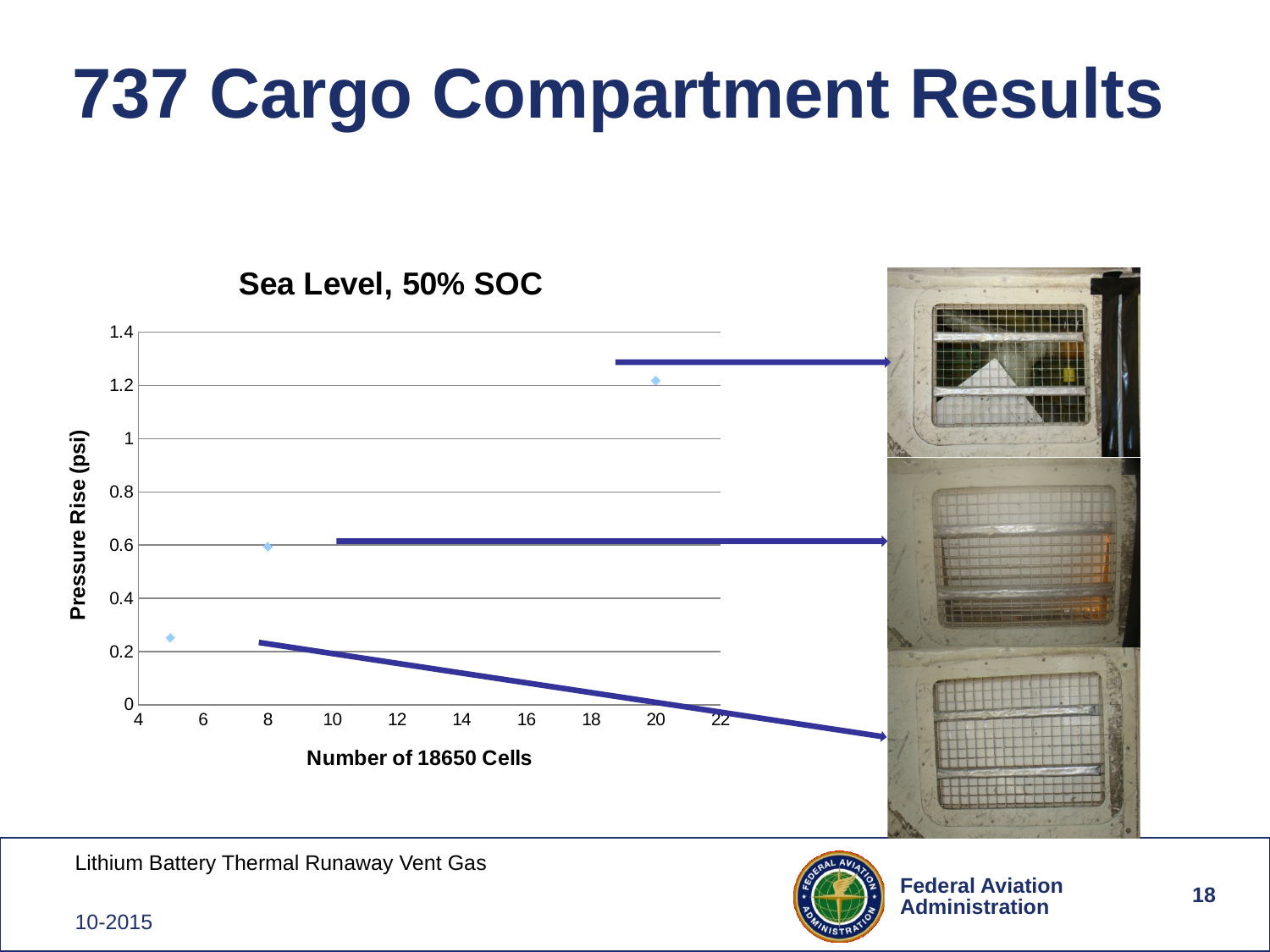
Is the pressure rise for 20 cells greater or less than 1.4 psi? less Is the pressure rise for 5 cells greater or less than 0.4 psi? less Which number of 18650 cells has the highest pressure rise? 20 Which has a larger pressure rise, 8 cells or 20 cells? 20 cells What is the title of the chart? Sea Level, 50% SOC How many data points are plotted in the chart? 3 What kind of chart is shown on the slide? scatter chart What is the label of the y axis of the chart? Pressure Rise (psi) Does the pressure rise increase or decrease as the number of 18650 cells increases? increase Which number of 18650 cells has the lowest pressure rise? 5 Is the pressure rise for 8 cells greater or less than 0.8 psi? less